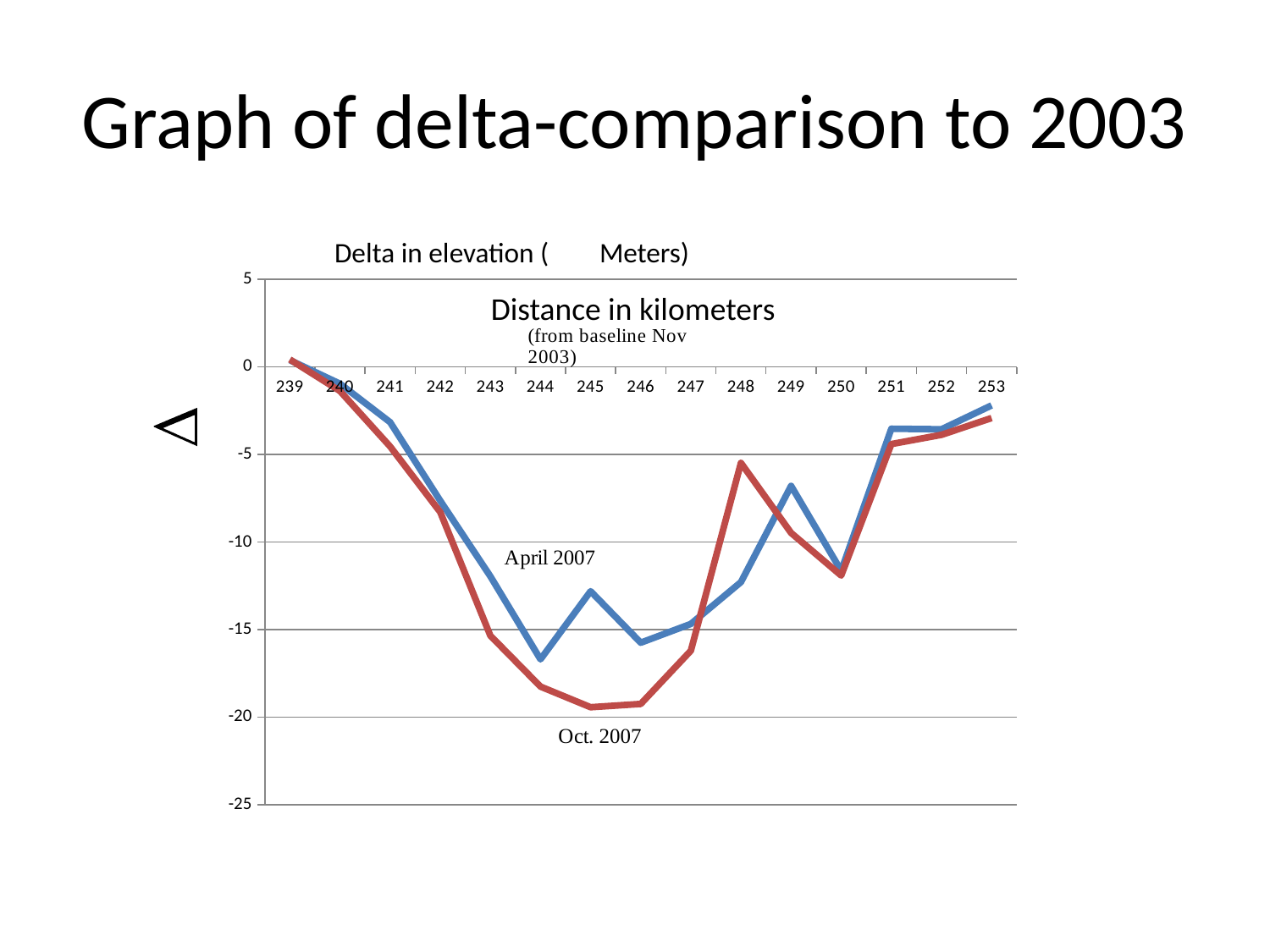
Which colour is used for the April 2007 line? blue At which distance does the April 2007 line reach its lowest value? 244 Does the Oct. 2007 line rise or fall between 239 km and 245 km? fall Is the Oct. 2007 value at 245 km greater or less than -15? less How many distance points are marked along the x axis of the chart? 15 How many data series are plotted in the chart? 2 Is the April 2007 value at 249 km greater or less than -10? greater At 248 km, which series has the higher value, April 2007 or Oct. 2007? Oct. 2007 Is the Oct. 2007 value at 248 km greater or less than -10? greater What kind of chart is shown on the slide? line chart What is the title printed above the chart? Delta in elevation (Meters)